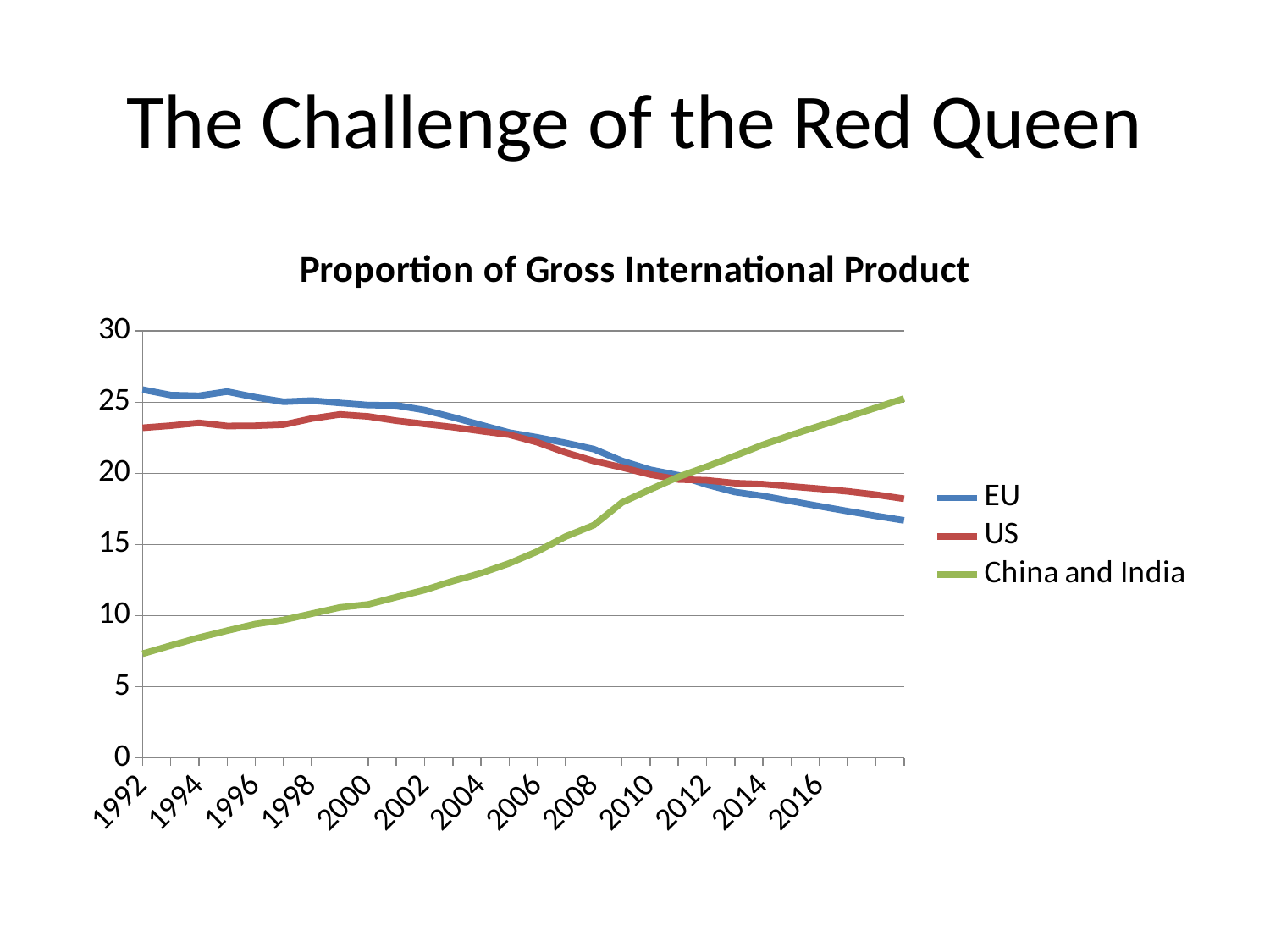
What is the title of the chart? Proportion of Gross International Product Which series has the lowest value in 1992? China and India Does the China and India line rise or fall from 1992 to 2016? rise Which series has the highest value in 1992? EU How many series does the legend list? 3 Is the value for China and India in 1992 greater or less than 10? less In 2004, which is larger, the EU value or the China and India value? EU Which series is shown in green? China and India Does the EU line rise or fall from 1992 to 2016? fall Which series has the highest value in 2016? China and India Is the value for US in 2016 greater or less than 20? less What kind of chart is shown on the slide? line chart